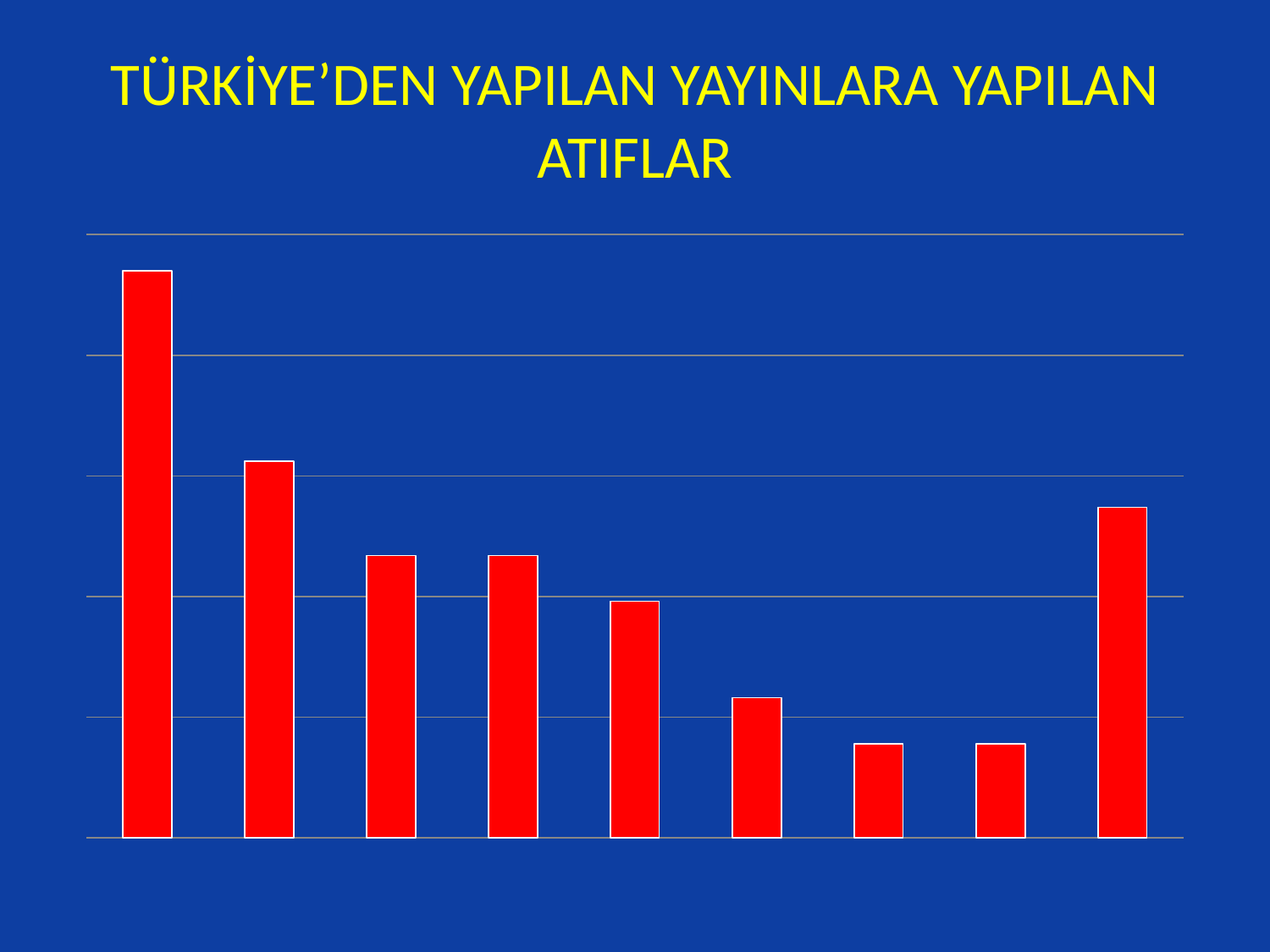
How many bars does the chart contain? 9 Which is taller, the second bar from the left or the last bar on the right? the second bar from the left Which is taller, the last bar on the right or the third bar from the left? the last bar on the right Which bar is the tallest in the chart? the first bar from the left What is the title of the slide containing the chart? TÜRKİYE'DEN YAPILAN YAYINLARA YAPILAN ATIFLAR Do the bar heights generally rise or fall from the first bar to the eighth bar? fall Which is taller, the fifth bar from the left or the sixth bar from the left? the fifth bar from the left What colour are the bars in the chart? red What kind of chart is shown on the slide? bar chart